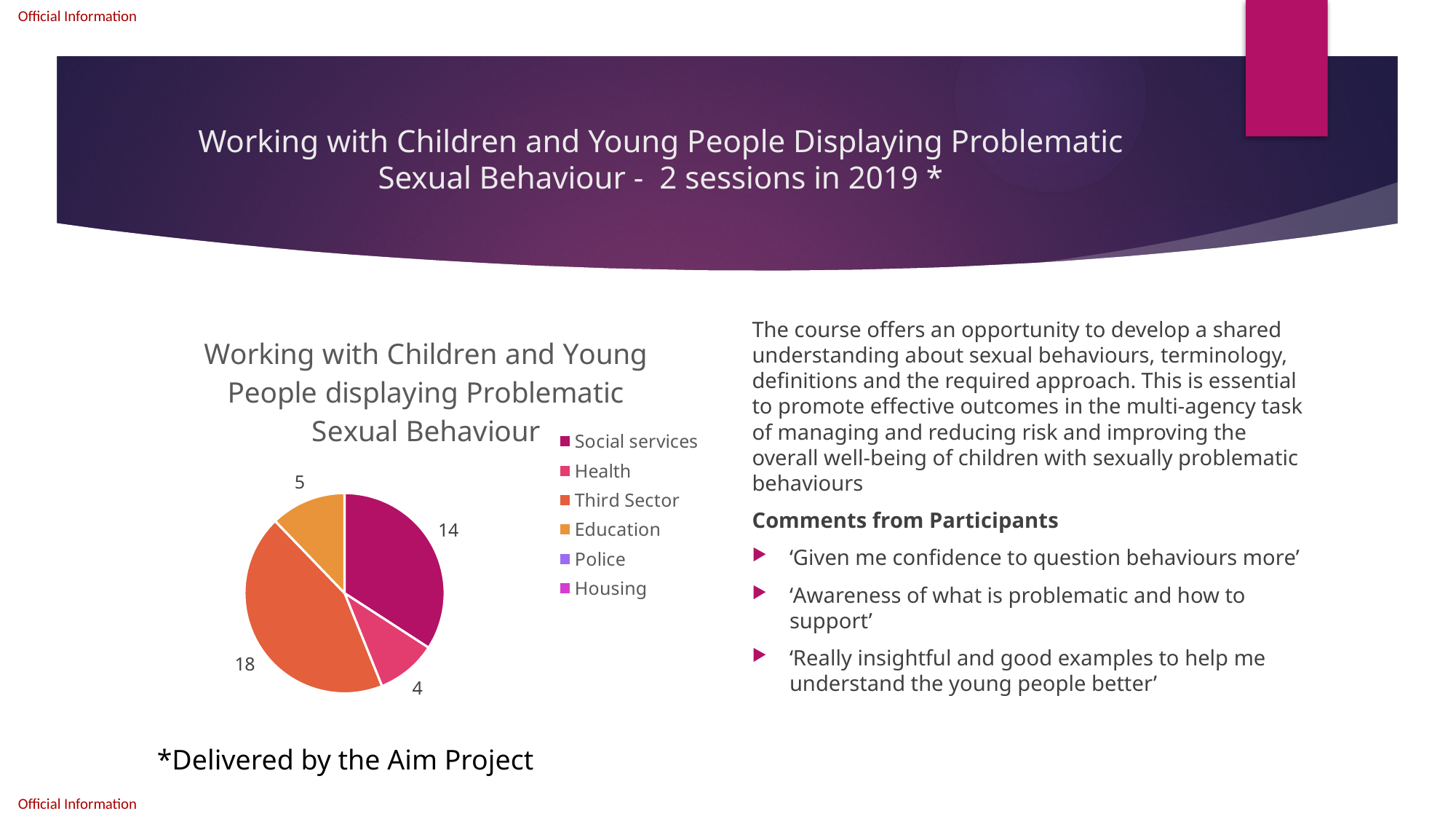
Which category has the largest slice in the pie chart? Third Sector What is the value for Education in the pie chart? 5 What type of chart is shown on the slide? pie chart Which of the labelled slices in the pie chart has the smallest value? Health What colour is the Third Sector slice in the pie chart? orange Which is larger in the pie chart, Education or Health? Education What is the value for Third Sector in the pie chart? 18 What is the value for Social services in the pie chart? 14 What is the title of the pie chart? Working with Children and Young People displaying Problematic Sexual Behaviour How many categories does the legend of the pie chart list? 6 What is the value for Health in the pie chart? 4 What is the difference between the Third Sector value and the Social services value? 4